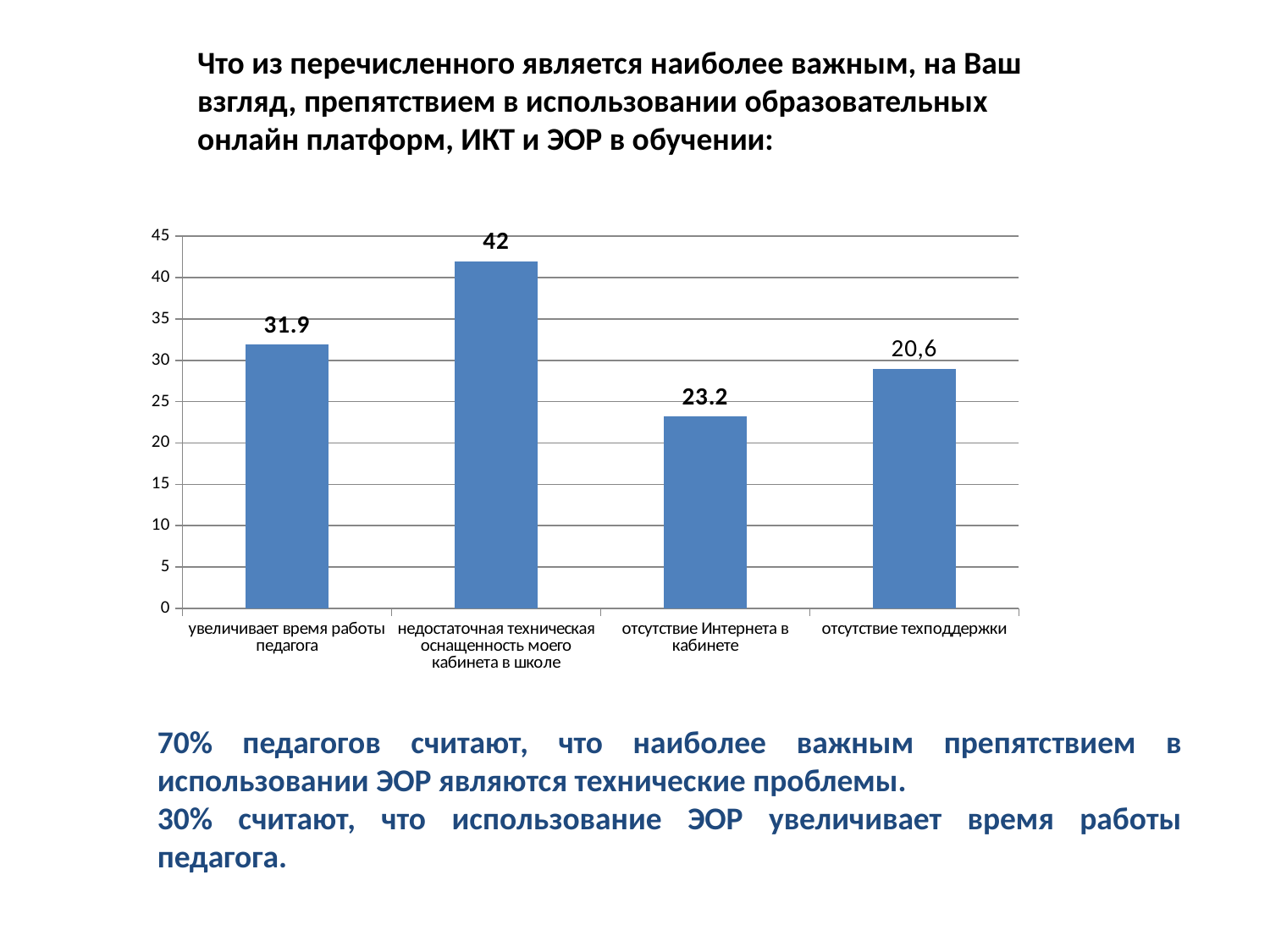
Which category has the highest value? недостаточная техническая оснащенность моего кабинета в школе Which is larger: the value for "увеличивает время работы педагога" or for "отсутствие Интернета в кабинете"? увеличивает время работы педагога What is the value for "отсутствие Интернета в кабинете"? 23.2 How many categories are plotted in the chart? 4 What type of chart is shown on the slide? bar chart What is the value for "увеличивает время работы педагога"? 31.9 Is the value for "отсутствие Интернета в кабинете" greater or less than 25? less What is the maximum value shown on the vertical axis of the chart? 45 Is the value for "недостаточная техническая оснащенность моего кабинета в школе" greater or less than 40? greater What is the difference between the values for "недостаточная техническая оснащенность моего кабинета в школе" and "увеличивает время работы педагога"? 10.1 What is the value for "недостаточная техническая оснащенность моего кабинета в школе"? 42 What is the difference between the values for "увеличивает время работы педагога" and "отсутствие Интернета в кабинете"? 8.7